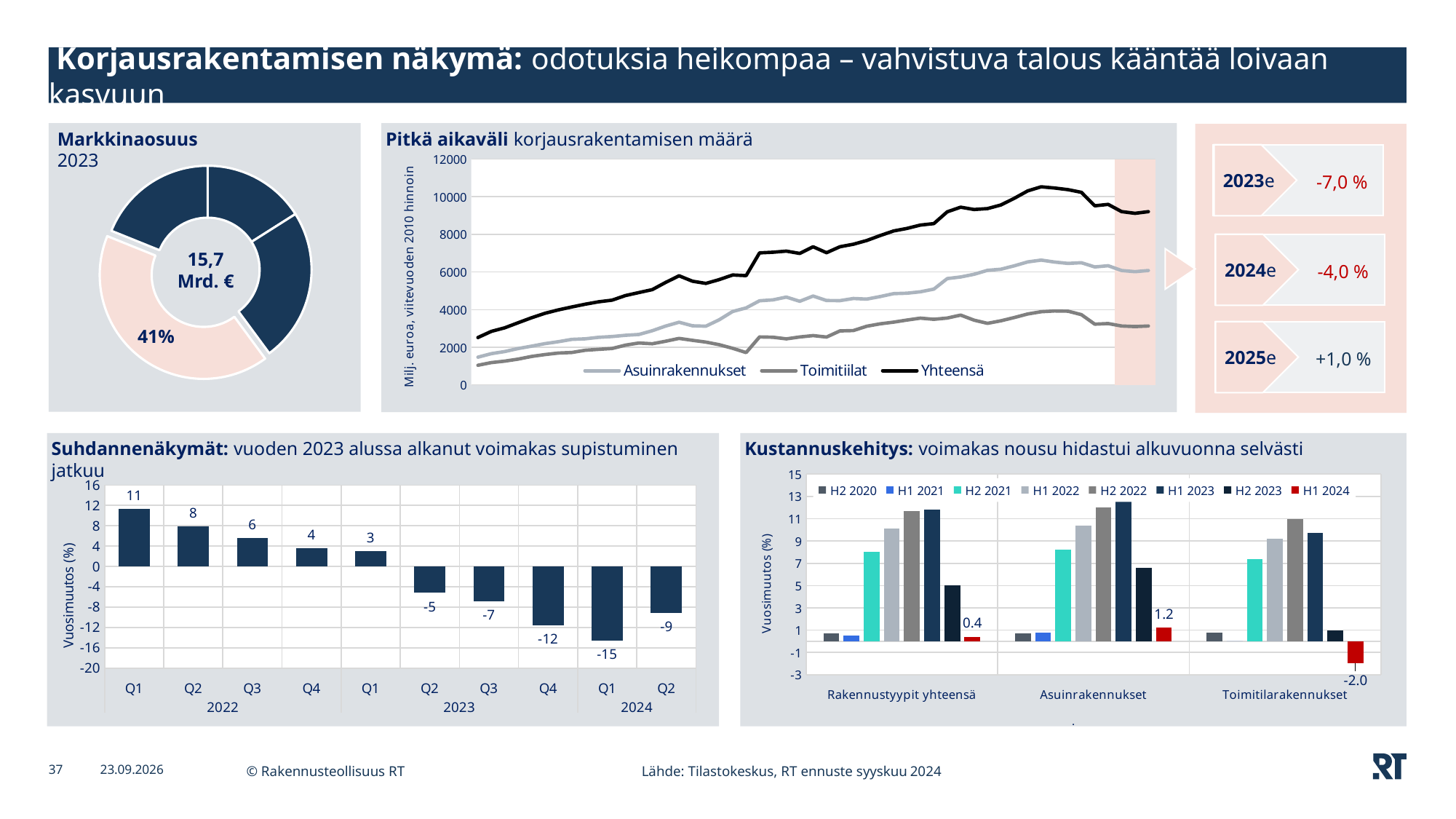
In the Kustannuskehitys chart, which is larger: the H1 2024 value for Rakennustyypit yhteensä or for Asuinrakennukset? Asuinrakennukset In the Suhdannenäkymät bar chart, what is the value for Q1 2022? 11 What kind of chart is the Markkinaosuus 2023 chart? donut chart In the Pitkä aikaväli line chart, is the final value of the Yhteensä line greater or less than 8000? greater In the Suhdannenäkymät chart, do the values rise or fall from Q1 2022 to Q4 2023? fall In the Suhdannenäkymät bar chart, what is the difference between the values for Q2 2022 and Q2 2024? 17 How many bars are plotted in the Suhdannenäkymät chart? 10 In the Suhdannenäkymät bar chart, what is the value for Q1 2024? -15 In the Markkinaosuus 2023 donut chart, what share is shown for the light pink slice? 41% In the Suhdannenäkymät bar chart, which quarter has the lowest value? Q1 2024 In the Kustannuskehitys chart, what is the H1 2024 value for Toimitilarakennukset? -2.0 How many series does the legend of the Kustannuskehitys chart list? 8